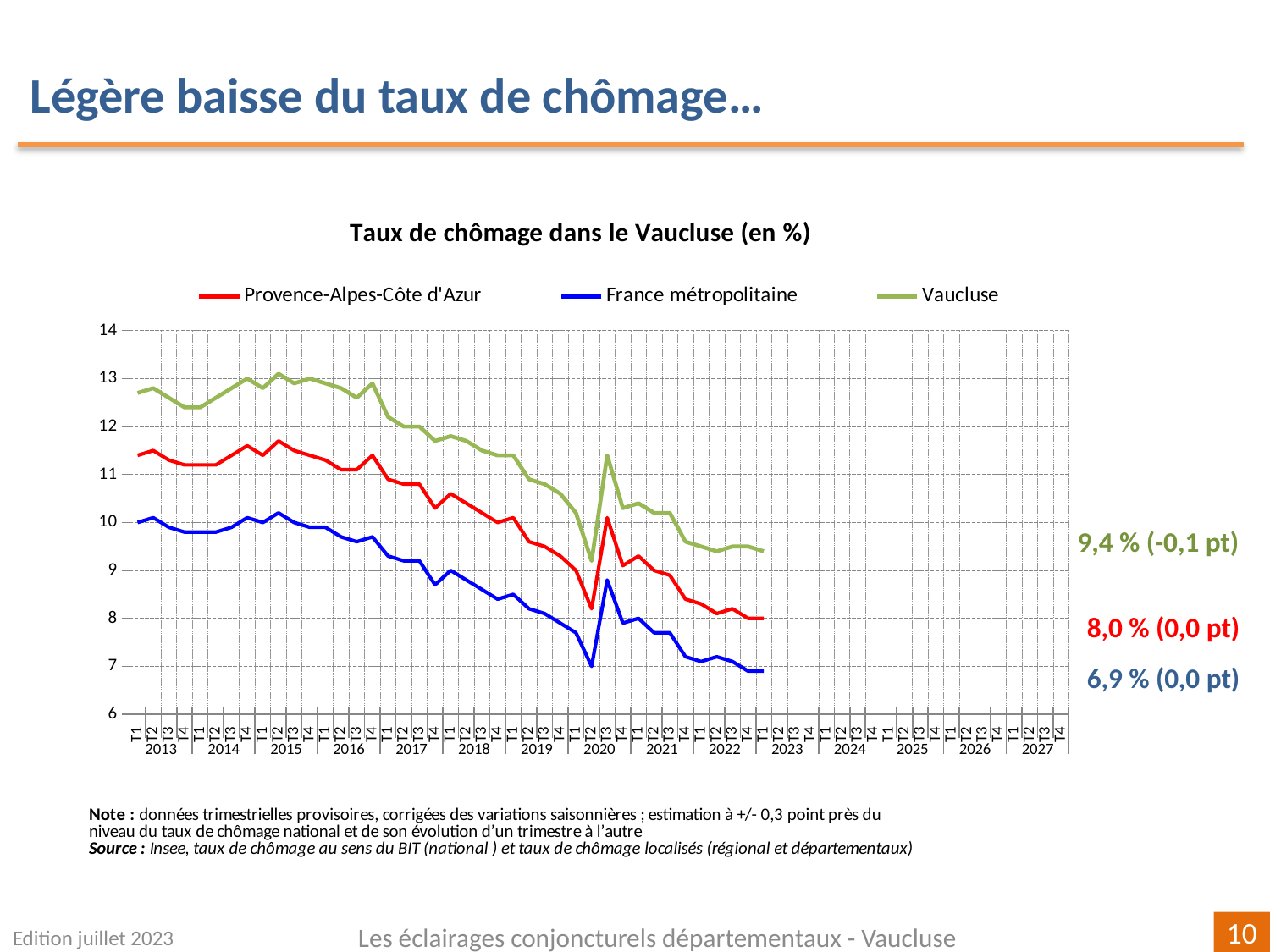
Do the unemployment rates generally rise or fall from 2013 to 2023? fall What is the latest unemployment rate shown for Vaucluse? 9,4 % How many series does the legend list? 3 Is the value for Vaucluse in 2015 greater or less than 12? greater What is the title of the chart? Taux de chômage dans le Vaucluse (en %) What kind of chart is shown on the slide? line chart What change is indicated next to the latest Vaucluse value? -0,1 pt What is the difference between the latest Vaucluse value and the latest France métropolitaine value? 2,5 What is the latest unemployment rate shown for Provence-Alpes-Côte d'Azur? 8,0 % Which series has the lowest latest value? France métropolitaine What is the latest unemployment rate shown for France métropolitaine? 6,9 % Which series has the highest latest value? Vaucluse